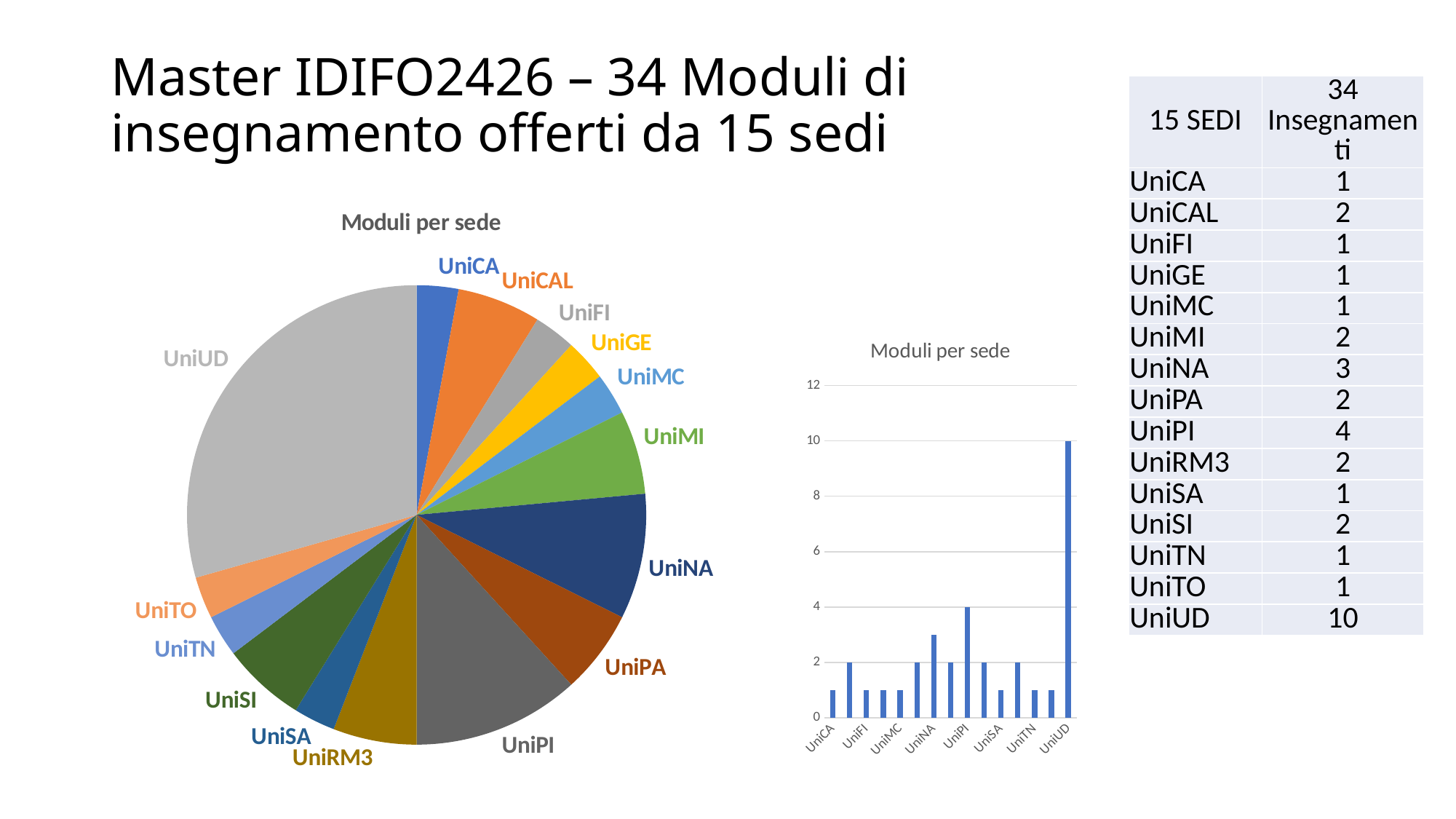
In the bar chart in the middle of the slide, what is the value for UniUD? 10 What kind of chart is the chart in the middle of the slide, to the right of the pie? bar chart In the bar chart in the middle of the slide, which is larger, the value for UniNA or the value for UniSA? UniNA In the bar chart in the middle of the slide, what is the value for UniNA? 3 In the bar chart in the middle of the slide, which category has the highest value? UniUD In the bar chart in the middle of the slide, what is the value for UniPI? 4 How many slices does the pie chart on the left have? 15 What kind of chart is the chart on the left of the slide? pie chart In the bar chart in the middle of the slide, what is the value for UniCA? 1 In the pie chart on the left, which slice is the largest? UniUD What is the title of the pie chart on the left? Moduli per sede In the bar chart in the middle of the slide, what is the difference between the values for UniUD and UniPI? 6